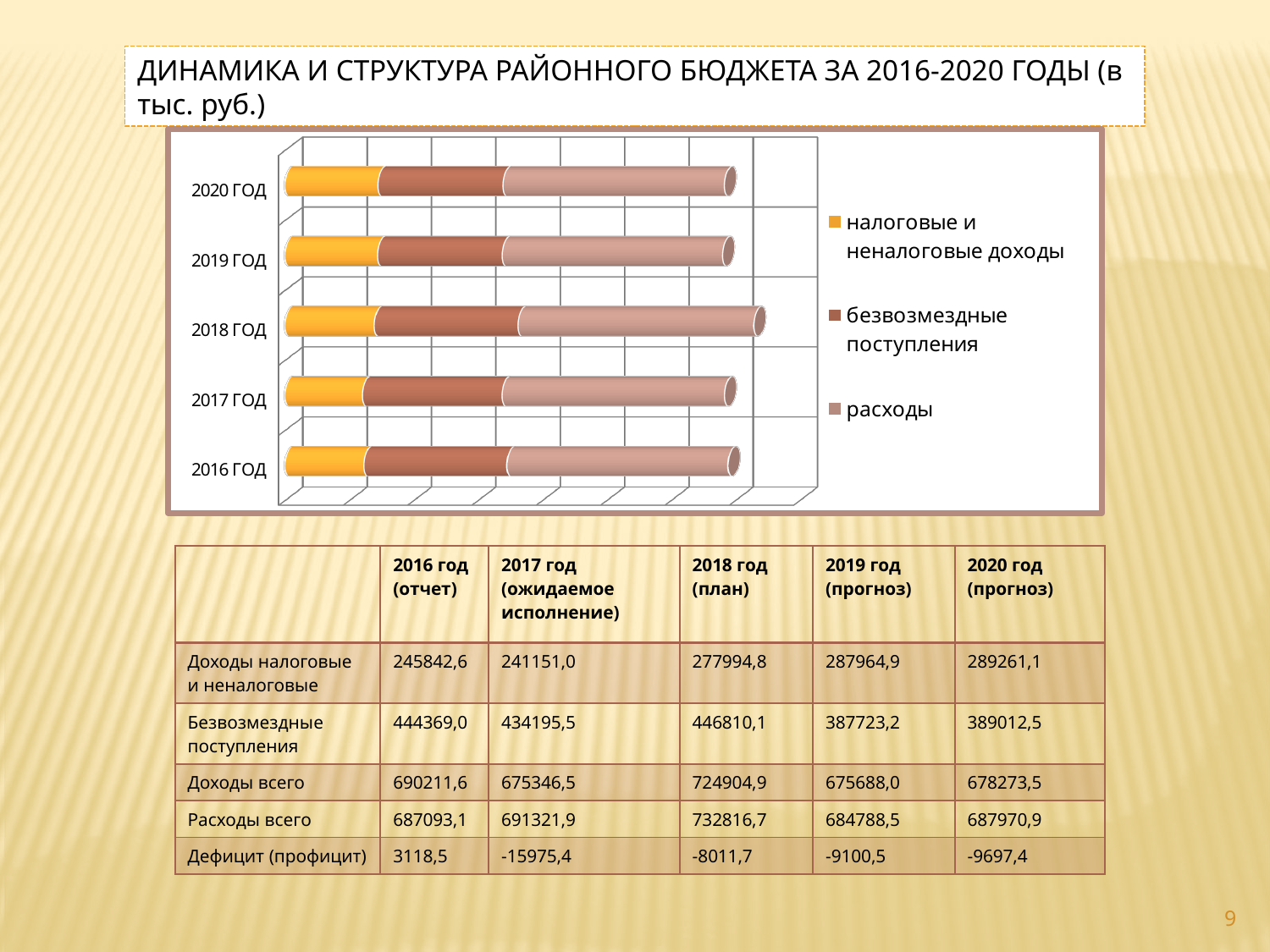
How many series does the chart legend list? 3 Which series has the longest segment in every bar of the chart? расходы What kind of chart is shown on the slide? Stacked bar chart Which year has the longest total stacked bar on the chart? 2018 год How many years (categories) are plotted on the chart? 5 In the bar for 2016 год, which segment is longer: расходы or налоговые и неналоговые доходы? расходы Which year is shown at the top of the chart? 2020 год Which series has the shortest segment in every bar of the chart? налоговые и неналоговые доходы What is the first entry in the chart legend? налоговые и неналоговые доходы In the bar for 2018 год, which segment is longer: налоговые и неналоговые доходы or безвозмездные поступления? безвозмездные поступления